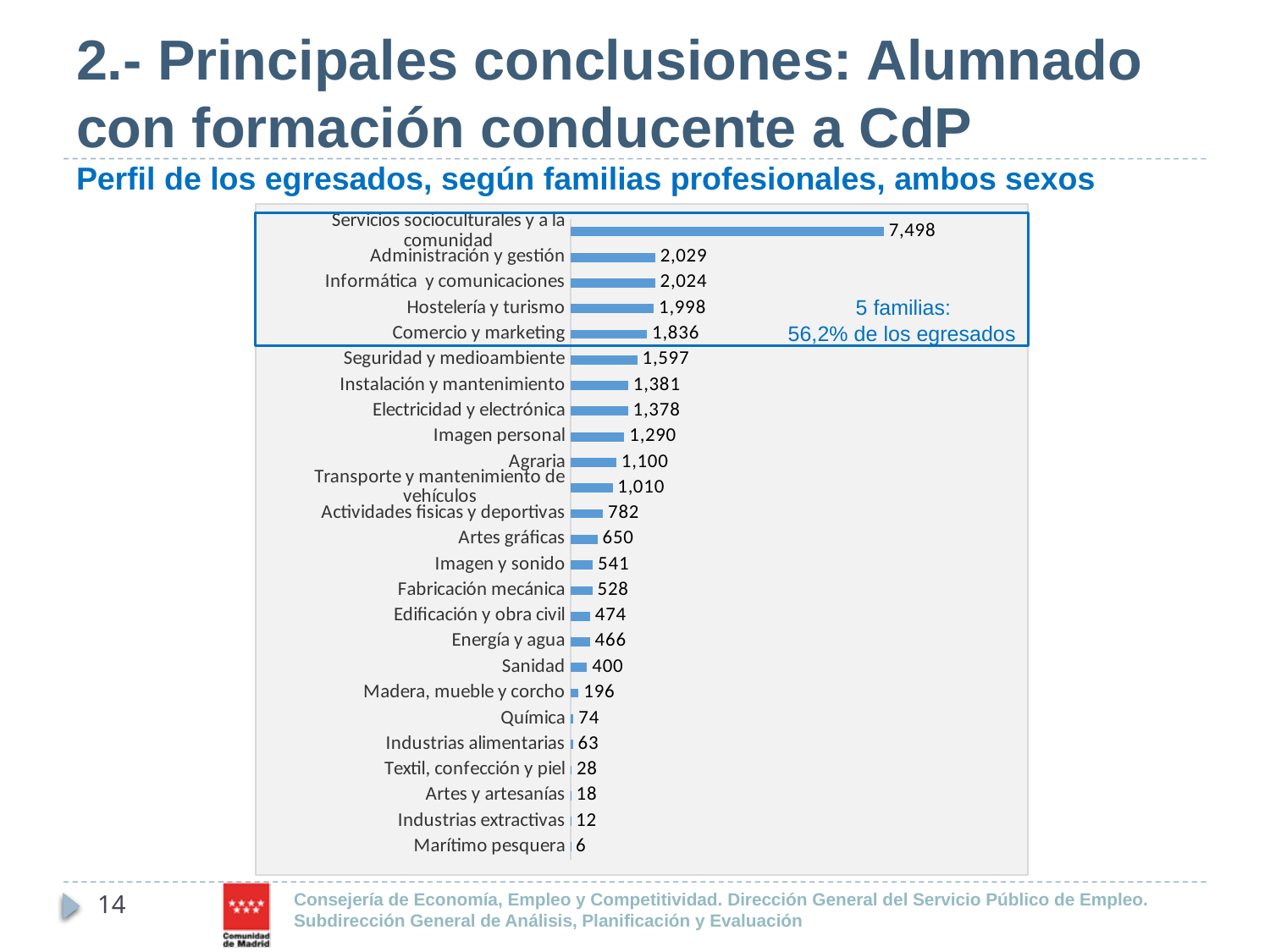
Which professional family has the highest value? Servicios socioculturales y a la comunidad What is the value for Química? 74 Which is larger, the value for Seguridad y medioambiente or the value for Imagen personal? Seguridad y medioambiente What is the difference between the values for Administración y gestión and Comercio y marketing? 193 What kind of chart is shown on the slide? Bar chart How many professional families are shown in the chart? 25 What is the value for Hostelería y turismo? 1,998 What is the value for Servicios socioculturales y a la comunidad? 7,498 Which professional family has the lowest value? Marítimo pesquera What is the value for Sanidad? 400 What is the difference between the values for Artes gráficas and Imagen y sonido? 109 According to the annotation in the chart, what share of graduates do the top 5 families represent? 56,2%